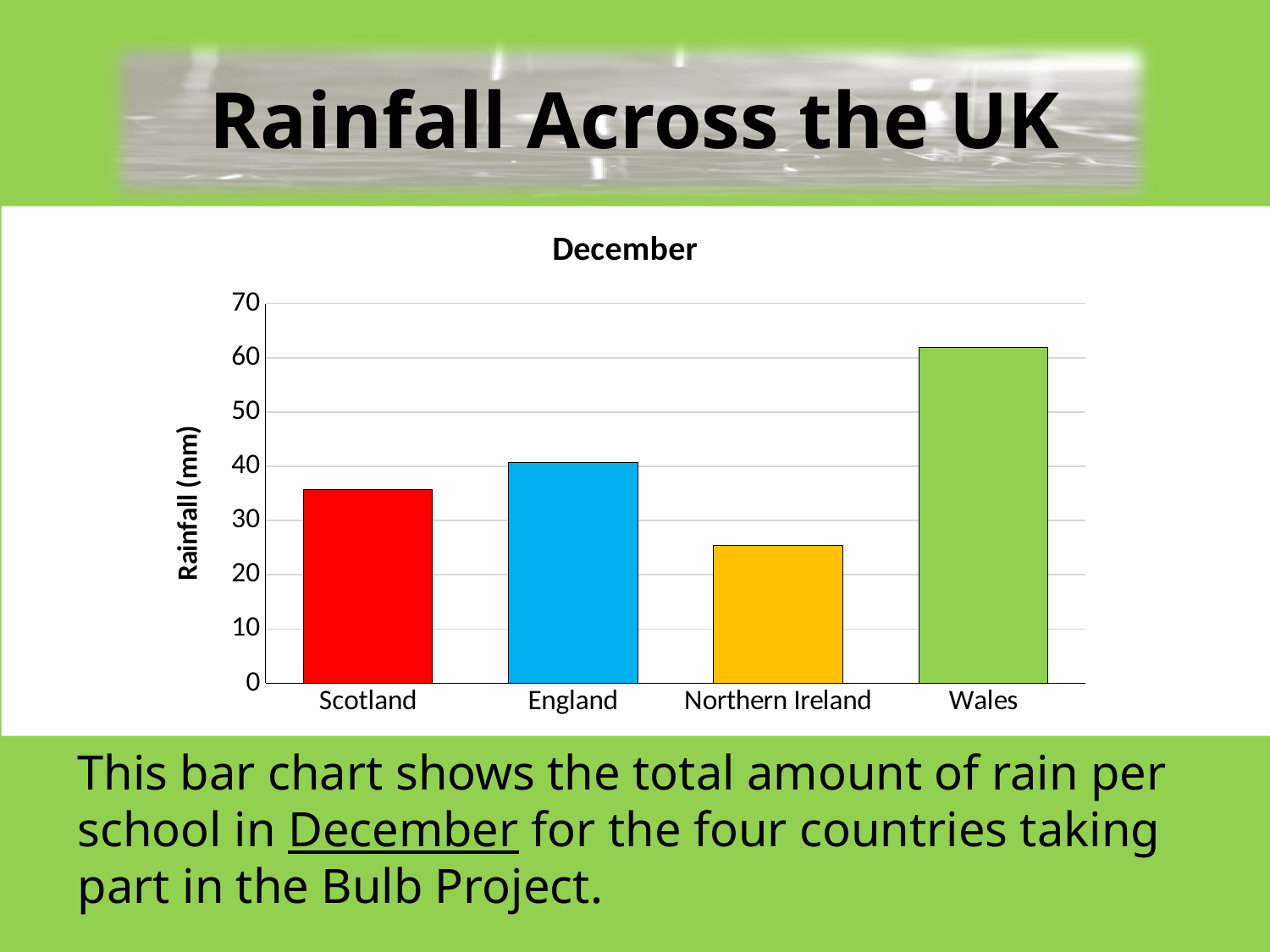
What kind of chart is shown on the slide? bar chart Is the rainfall value for Wales greater or less than 50? greater Which country has the lowest rainfall in the December chart? Northern Ireland How many countries are shown in the chart? 4 Which country has the highest rainfall in the December chart? Wales Is the rainfall value for Scotland greater or less than 30? greater Is the rainfall value for England greater or less than 50? less Which has more rainfall, Wales or England? Wales What is the label on the vertical axis of the chart? Rainfall (mm) What is the title of the chart? December